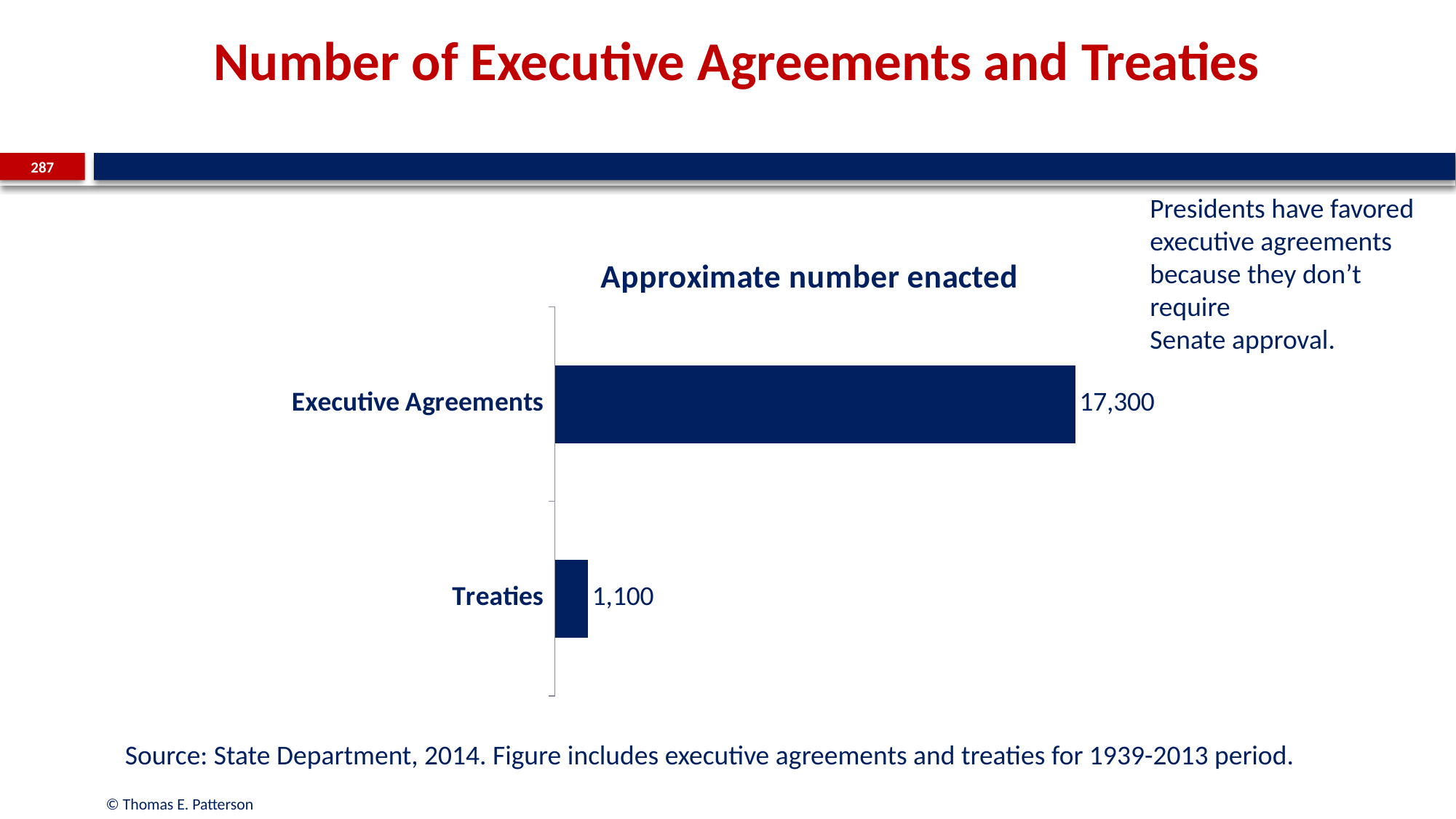
What is the total of the two values shown in the chart? 18,400 What kind of chart is shown on the slide? Bar chart What is the approximate number of Treaties enacted? 1,100 Which category has the lowest value? Treaties Which is larger, the value for Executive Agreements or the value for Treaties? Executive Agreements What is the difference between the number of Executive Agreements and the number of Treaties? 16,200 What colour are the bars in the chart? Dark blue What is the approximate number of Executive Agreements enacted? 17,300 How many categories are shown in the chart? 2 Which category has the highest value? Executive Agreements What is the title of the chart? Approximate number enacted